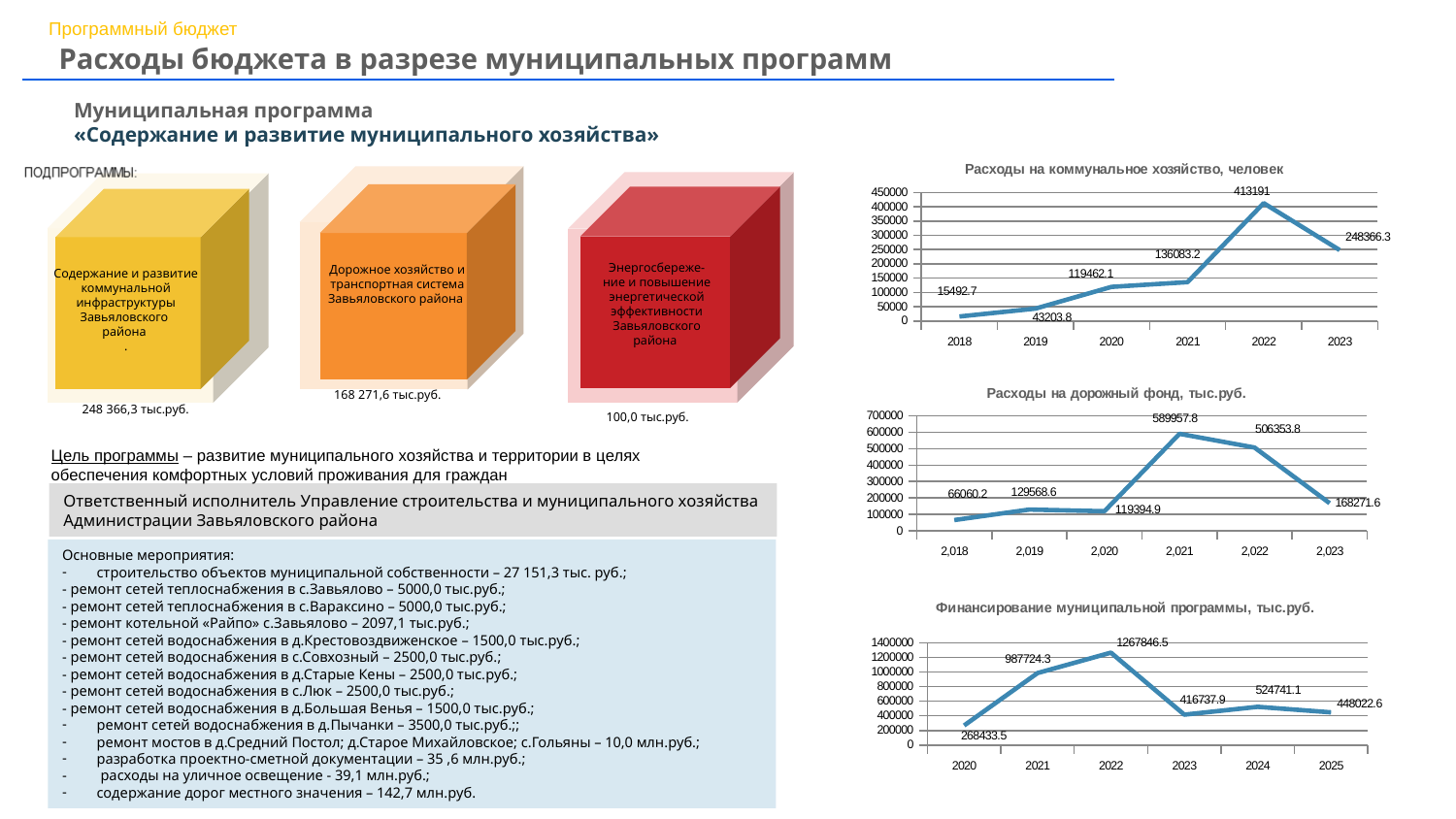
In the chart 'Финансирование муниципальной программы, тыс.руб.', is the value for 2021 greater or less than 800000? greater In the chart 'Финансирование муниципальной программы, тыс.руб.', what is the value for 2022? 1267846.5 In the chart 'Расходы на коммунальное хозяйство, человек', how many data points are plotted? 6 What type of chart is 'Финансирование муниципальной программы, тыс.руб.'? Line chart In the chart 'Расходы на дорожный фонд, тыс.руб.', what is the difference between the values for 2,021 and 2,022? 83604 In the chart 'Расходы на дорожный фонд, тыс.руб.', which year has the highest value? 2,021 In the chart 'Расходы на коммунальное хозяйство, человек', do the values rise or fall from 2018 to 2022? Rise In the chart 'Финансирование муниципальной программы, тыс.руб.', which year has the lowest value? 2020 In the chart 'Расходы на коммунальное хозяйство, человек', what is the value for 2022? 413191 In the chart 'Расходы на дорожный фонд, тыс.руб.', what is the value for 2,021? 589957.8 In the chart 'Расходы на коммунальное хозяйство, человек', which year has the lowest value? 2018 In the chart 'Расходы на дорожный фонд, тыс.руб.', which is larger: the value for 2,019 or the value for 2,020? 2,019